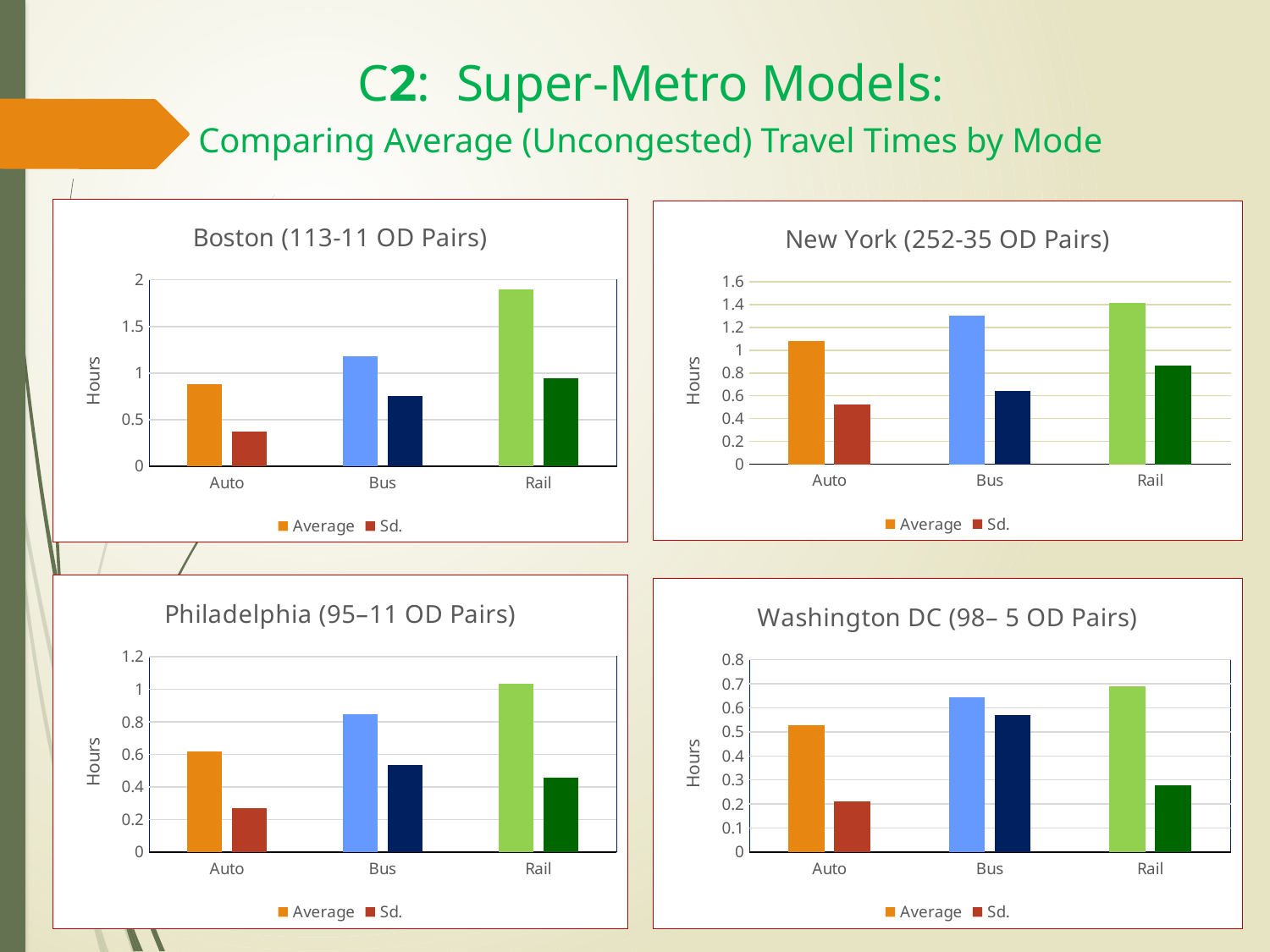
What kind of chart is the Philadelphia (95–11 OD Pairs) chart? bar chart In the Washington DC (98– 5 OD Pairs) chart, which mode has the highest Sd. value? Bus How many series does the legend of the New York (252-35 OD Pairs) chart list? 2 In the Philadelphia (95–11 OD Pairs) chart, is the Average value for Auto greater or less than 0.8? less In the Washington DC (98– 5 OD Pairs) chart, is the Average value for Auto greater or less than 0.6? less In the New York (252-35 OD Pairs) chart, is the Sd. value for Auto greater or less than 0.6? less In the Boston (113-11 OD Pairs) chart, which mode has the highest Average travel time? Rail In the Boston (113-11 OD Pairs) chart, does the Average value rise or fall going from Auto to Bus to Rail? rise In the Philadelphia (95–11 OD Pairs) chart, which has the larger Sd. value, Bus or Rail? Bus In the New York (252-35 OD Pairs) chart, which mode has the lowest Sd. value? Auto How many modes (categories) are shown on the x axis of the Boston (113-11 OD Pairs) chart? 3